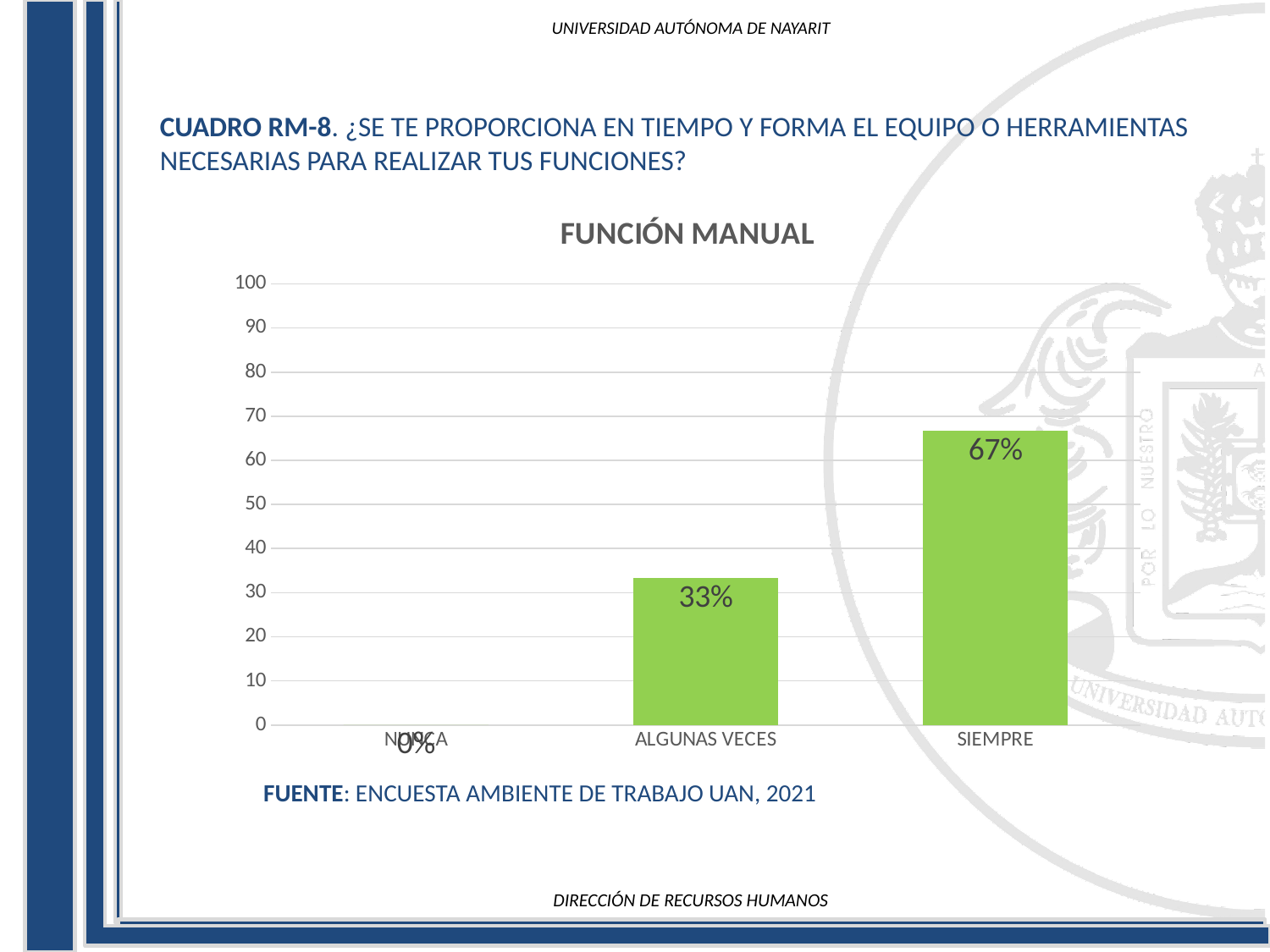
What kind of chart is shown? bar chart What is the difference between the values for SIEMPRE and ALGUNAS VECES? 34% Which is larger, the value for ALGUNAS VECES or the value for SIEMPRE? SIEMPRE Is the value for ALGUNAS VECES greater or less than 40? less What is the value for NUNCA? 0% What is the value for SIEMPRE? 67% Is the value for SIEMPRE greater or less than 60? greater How many categories are shown on the x axis? 3 Which category has the lowest value? NUNCA Which category has the highest value? SIEMPRE What is the value for ALGUNAS VECES? 33% What is the title of the chart? FUNCIÓN MANUAL